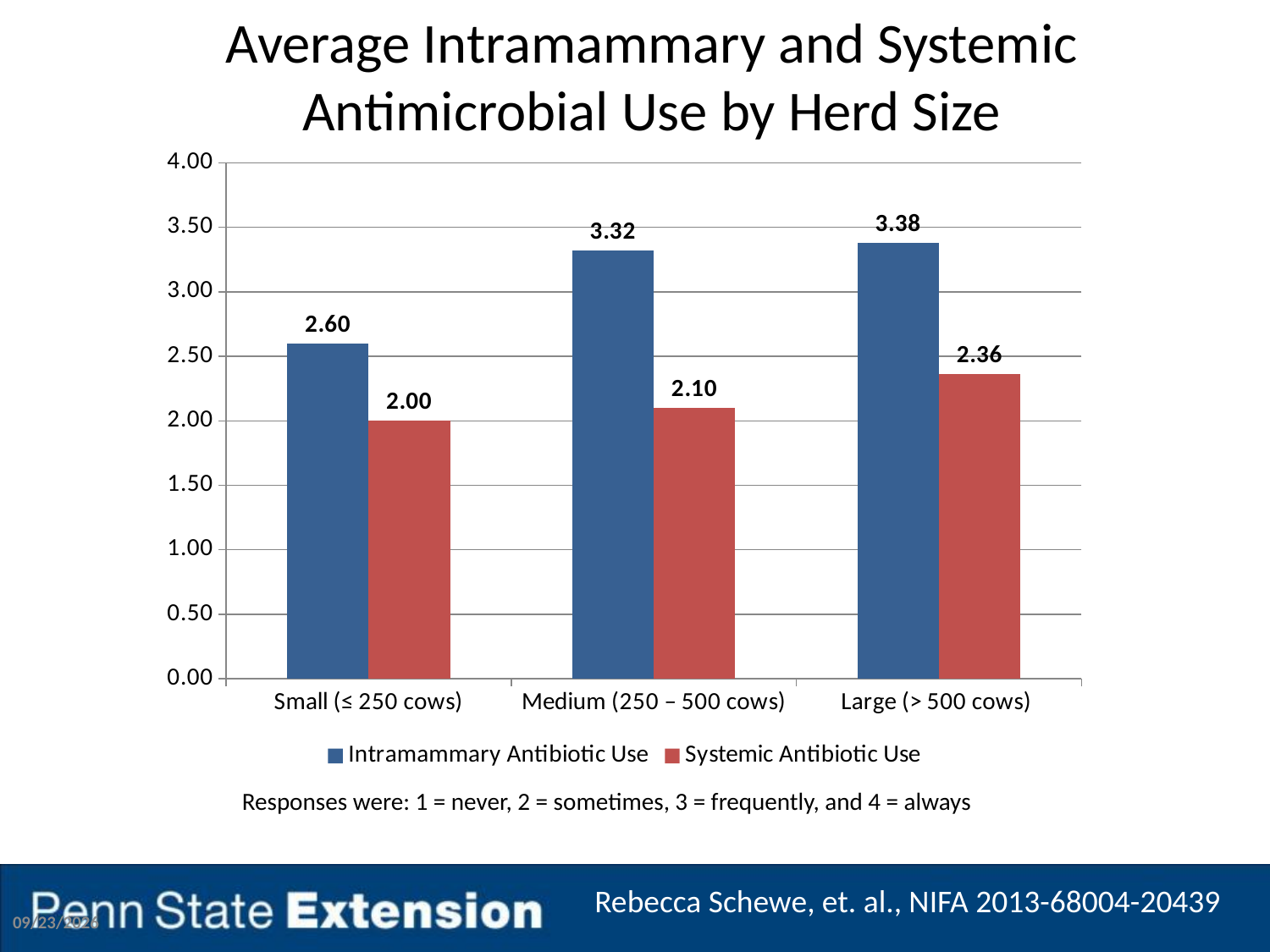
Which herd size has the lowest Systemic Antibiotic Use? Small (≤ 250 cows) How many series does the legend list? 2 What is the Systemic Antibiotic Use value for Medium (250 – 500 cows)? 2.10 Does Systemic Antibiotic Use rise or fall as herd size increases from Small to Large? Rise What is the difference between Intramammary and Systemic Antibiotic Use for Medium (250 – 500 cows)? 1.22 Is the Intramammary Antibiotic Use value for Large (> 500 cows) greater or less than 3.00? greater How many herd size categories are shown on the x axis? 3 Which herd size has the highest Intramammary Antibiotic Use? Large (> 500 cows) Which is larger for Small (≤ 250 cows): Intramammary Antibiotic Use or Systemic Antibiotic Use? Intramammary Antibiotic Use What is the Intramammary Antibiotic Use value for Small (≤ 250 cows)? 2.60 What kind of chart is shown on the slide? Bar chart What is the Systemic Antibiotic Use value for Large (> 500 cows)? 2.36